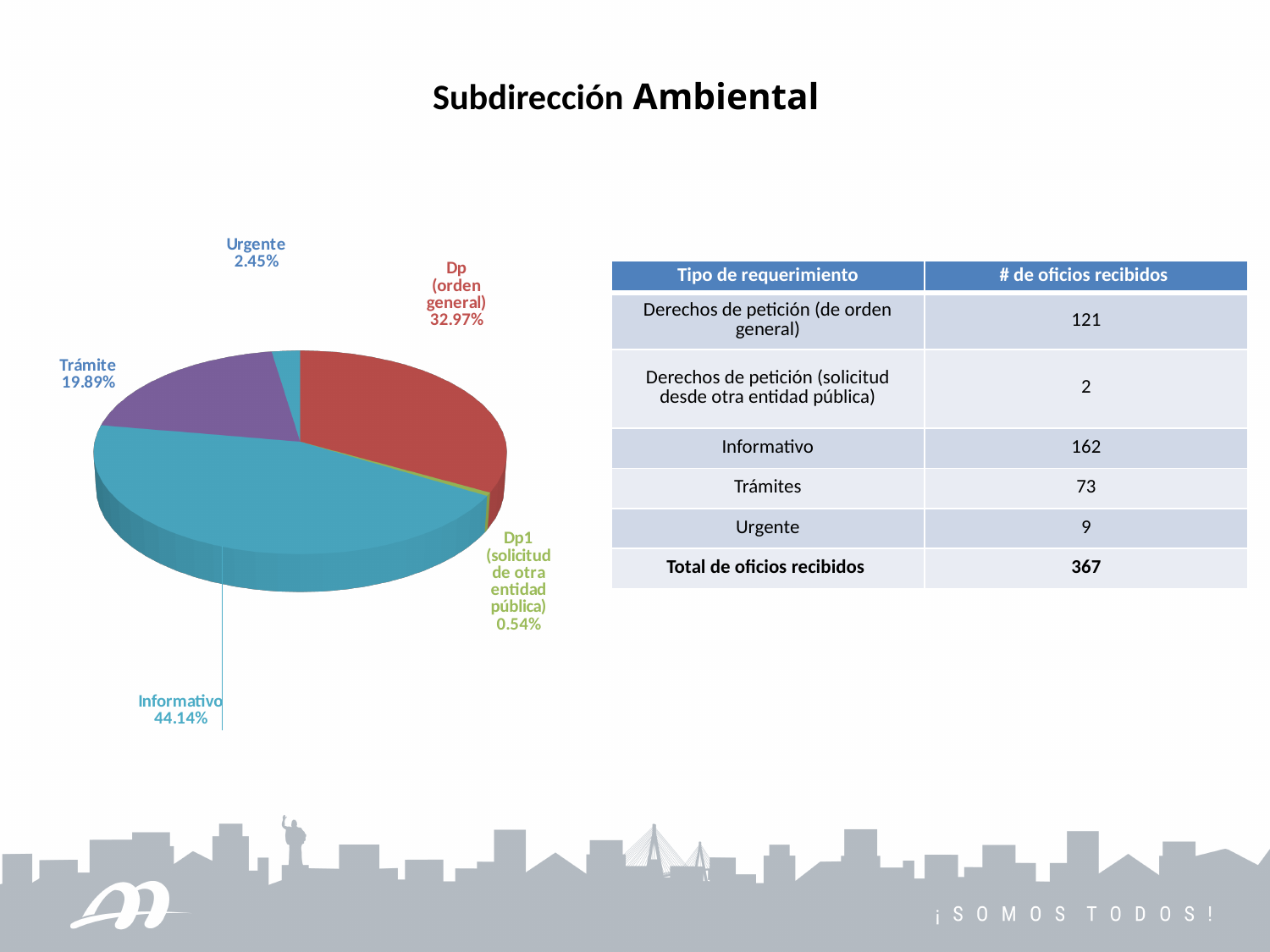
Which slice is larger in the pie chart, Trámite or Urgente? Trámite How many slices does the pie chart have? 5 What colour is the Informativo slice in the pie chart? teal/blue What is the difference in percentage points between the Informativo and Dp (orden general) slices? 11.17 What percentage share does the Trámite slice have in the pie chart? 19.89% What type of chart is shown on the slide? pie chart What percentage share does the Urgente slice have in the pie chart? 2.45% What percentage share does the Informativo slice have in the pie chart? 44.14% What percentage share does the Dp (orden general) slice have in the pie chart? 32.97% What percentage share does the Dp1 (solicitud de otra entidad pública) slice have in the pie chart? 0.54% Which category has the largest slice in the pie chart? Informativo Which category has the smallest slice in the pie chart? Dp1 (solicitud de otra entidad pública)